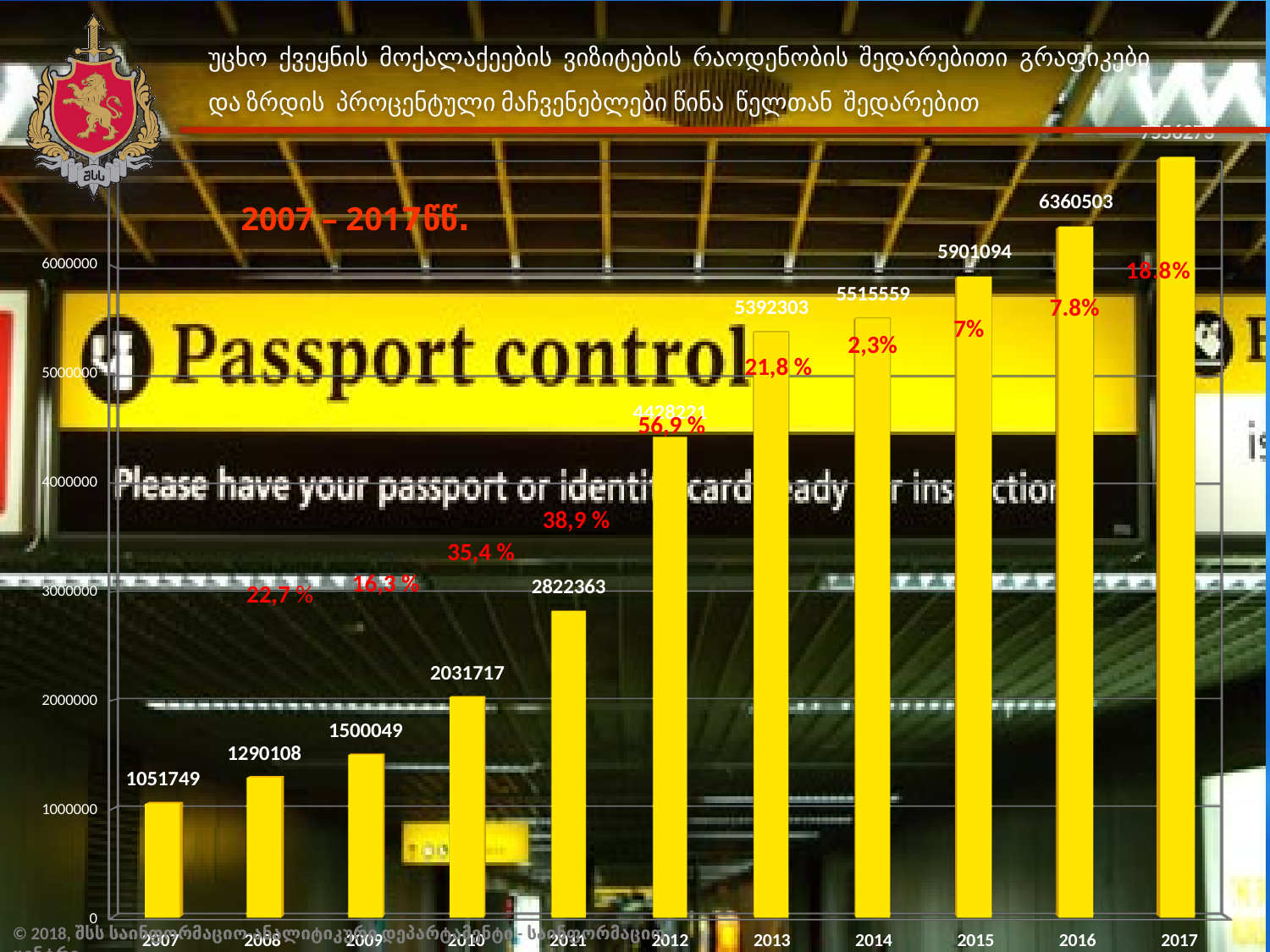
Which year has the highest bar? 2017 What is the difference between the values for 2008 and 2007? 238359 What is the value shown for 2011? 2822363 What growth percentage is shown in red for 2016? 7.8% Which year has the lowest bar? 2007 How many years are shown on the x axis? 11 Is the value for 2017 greater or less than 6000000? greater What is the value shown for 2007? 1051749 What is the value shown for 2014? 5515559 Which is larger, the value for 2010 or the value for 2011? 2011 What growth percentage is shown in red for 2012? 56,9 % What is the value shown for 2016? 6360503